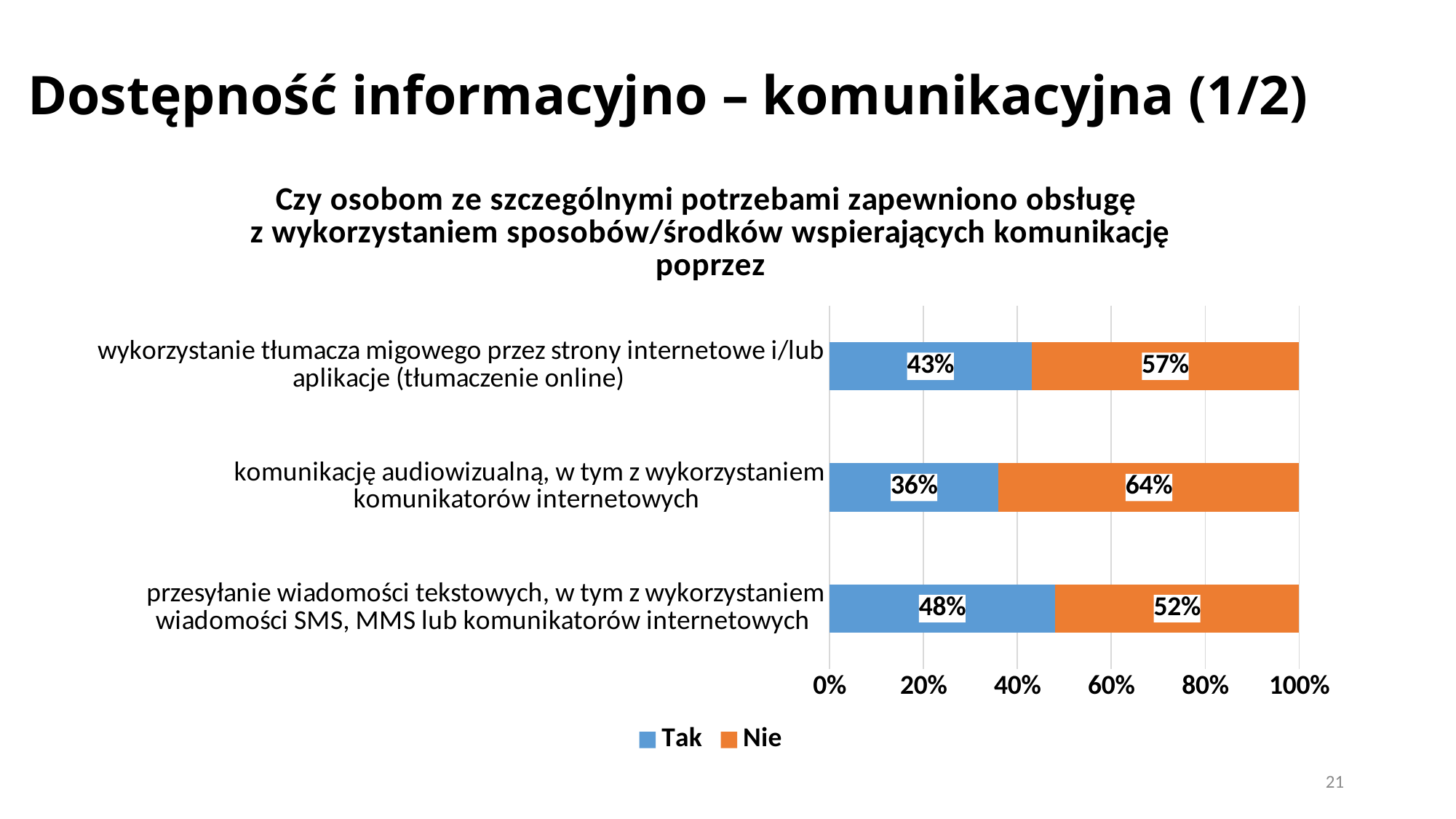
What is the total of the stacked bar for 'wykorzystanie tłumacza migowego przez strony internetowe i/lub aplikacje (tłumaczenie online)'? 100% Which is larger for 'wykorzystanie tłumacza migowego przez strony internetowe i/lub aplikacje (tłumaczenie online)': 'Tak' or 'Nie'? Nie Which category has the lowest 'Tak' value? komunikację audiowizualną, w tym z wykorzystaniem komunikatorów internetowych What kind of chart is shown on the slide? stacked bar chart What is the difference between the 'Nie' and 'Tak' values for 'komunikację audiowizualną, w tym z wykorzystaniem komunikatorów internetowych'? 28% What is the 'Tak' value for 'wykorzystanie tłumacza migowego przez strony internetowe i/lub aplikacje (tłumaczenie online)'? 43% What is the 'Nie' value for 'komunikację audiowizualną, w tym z wykorzystaniem komunikatorów internetowych'? 64% How many series does the legend list? 2 Which category has the highest 'Tak' value? przesyłanie wiadomości tekstowych, w tym z wykorzystaniem wiadomości SMS, MMS lub komunikatorów internetowych How many categories are shown in the chart? 3 Is the 'Tak' value for 'przesyłanie wiadomości tekstowych, w tym z wykorzystaniem wiadomości SMS, MMS lub komunikatorów internetowych' greater or less than 40%? greater What is the 'Tak' value for 'przesyłanie wiadomości tekstowych, w tym z wykorzystaniem wiadomości SMS, MMS lub komunikatorów internetowych'? 48%